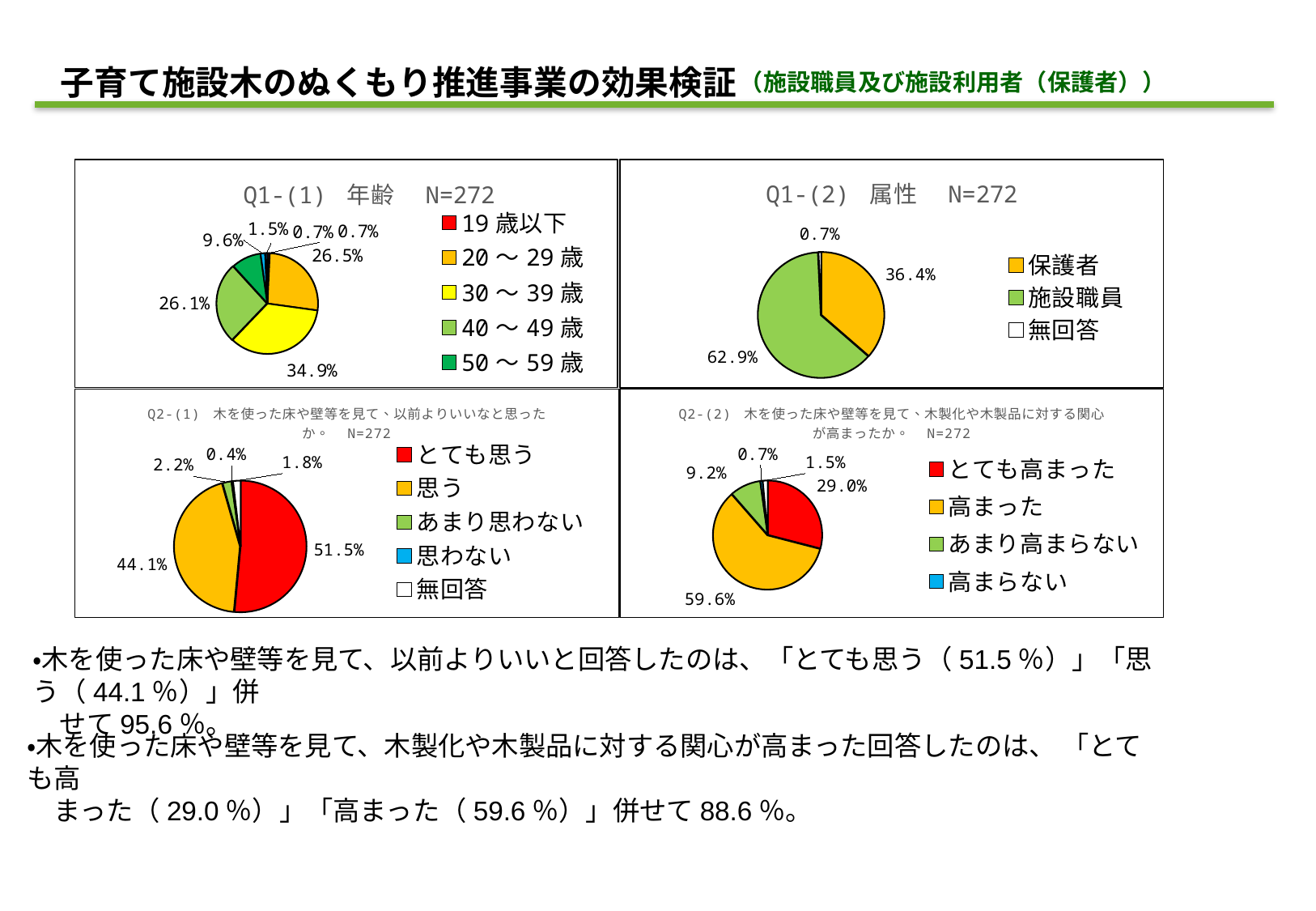
What type of chart is used for Q1-(2) 属性? Pie chart In the Q1-(1) 年齢 chart, which age group has the largest share? 30～39歳 In the Q2-(2) chart, which is larger, とても高まった or あまり高まらない? とても高まった In the Q1-(2) 属性 chart, which category has the largest share? 施設職員 In the Q1-(1) 年齢 chart, what percentage is 30～39歳? 34.9% In the Q2-(1) chart, what is the combined share of とても思う and 思う? 95.6% In the Q1-(2) 属性 chart, what percentage is 保護者? 36.4% In the Q1-(1) 年齢 chart, what is the difference between 20～29歳 and 50～59歳? 16.9% In the Q1-(2) 属性 chart, what percentage is 施設職員? 62.9% In the Q2-(1) chart, how many entries does the legend list? 5 In the Q2-(1) chart, what percentage answered とても思う? 51.5% In the Q2-(2) chart, what percentage answered 高まった? 59.6%